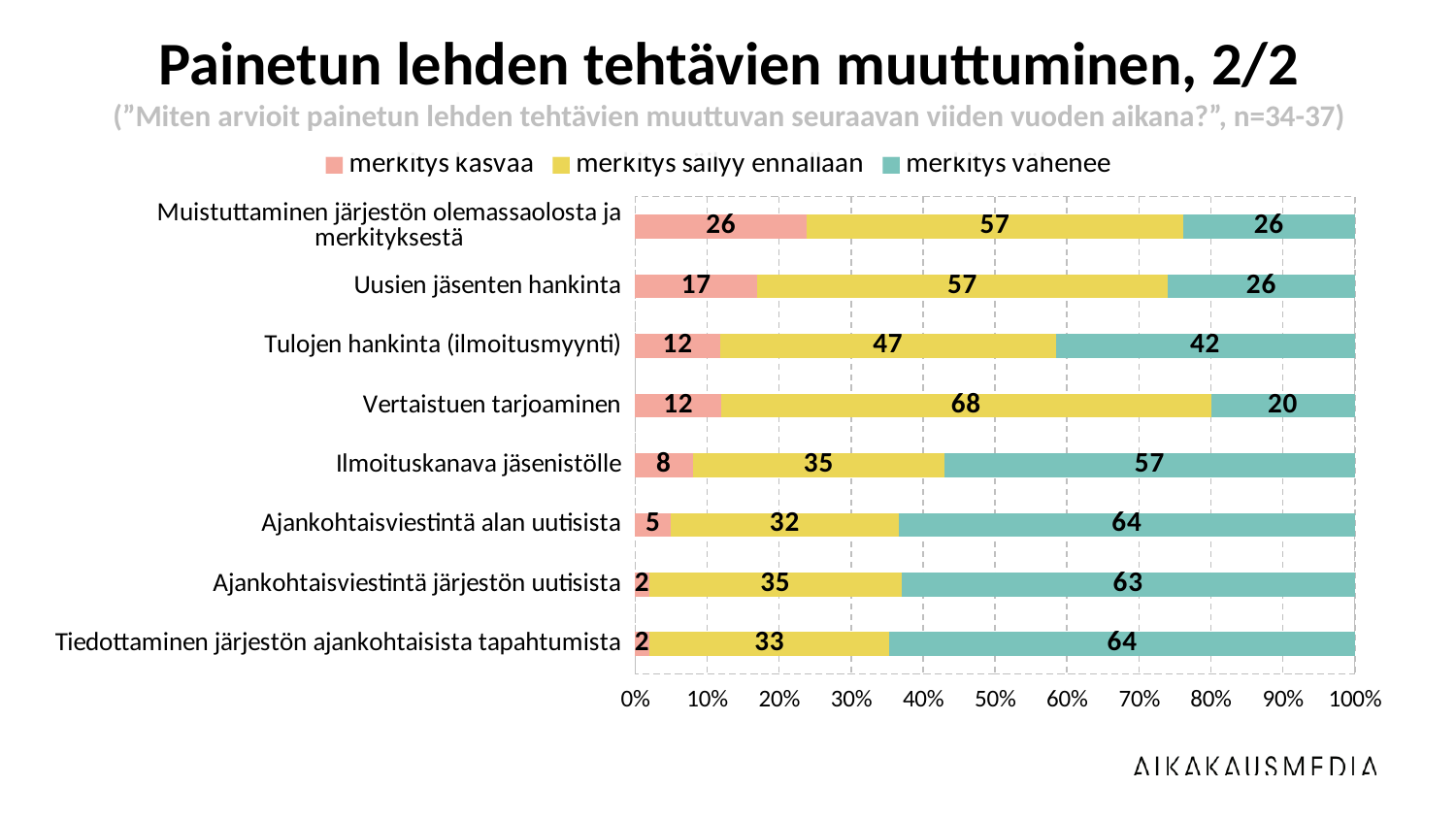
What is the value for "merkitys vähenee" for Tulojen hankinta (ilmoitusmyynti)? 42 Which category has the highest value for "merkitys kasvaa"? Muistuttaminen järjestön olemassaolosta ja merkityksestä How many series does the legend list? 3 What is the value for "merkitys säilyy ennallaan" for Vertaistuen tarjoaminen? 68 What is the value for "merkitys kasvaa" for Uusien jäsenten hankinta? 17 Which is larger: the "merkitys vähenee" value for Ajankohtaisviestintä alan uutisista or for Ajankohtaisviestintä järjestön uutisista? Ajankohtaisviestintä alan uutisista What kind of chart is shown on the slide? Stacked bar chart How many categories are shown on the chart? 8 What is the difference between the "merkitys vähenee" values for Ilmoituskanava jäsenistölle and Vertaistuen tarjoaminen? 37 Which series is shown in yellow in the legend? merkitys säilyy ennallaan What is the value for "merkitys kasvaa" for Tiedottaminen järjestön ajankohtaisista tapahtumista? 2 Which category has the lowest value for "merkitys säilyy ennallaan"? Ajankohtaisviestintä alan uutisista